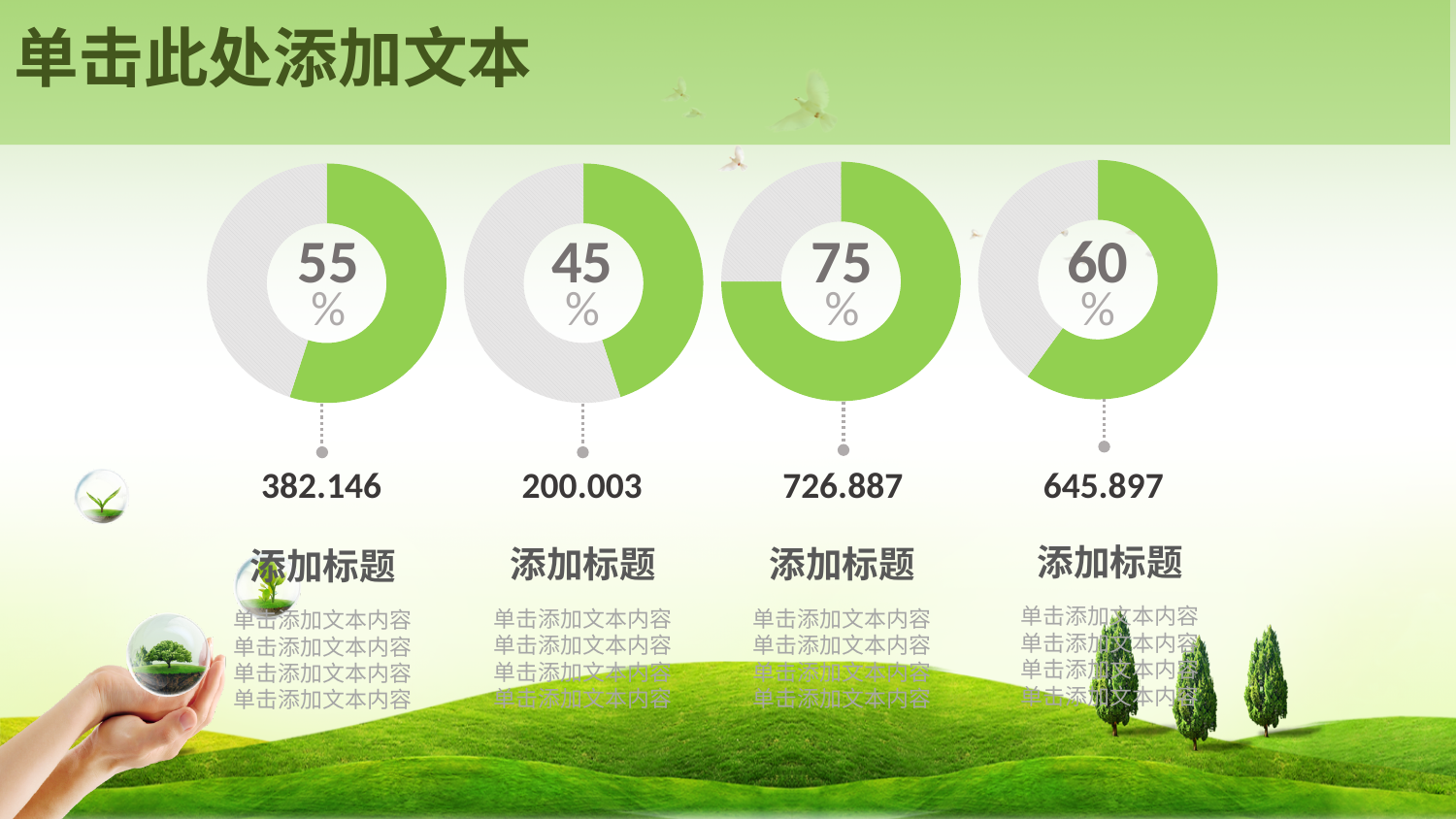
Which is larger: the percentage in the leftmost donut chart or the percentage in the rightmost donut chart? The rightmost (60%) What percentage is shown in the centre of the third donut chart from the left? 75% What is the difference between the percentage in the third donut chart and the percentage in the second donut chart? 30% What percentage is shown in the centre of the rightmost donut chart? 60% What type of chart is used to display the percentages on the slide? Donut (pie) chart What percentage is shown in the centre of the leftmost donut chart? 55% How many donut charts are shown on the slide? 4 What percentage is shown in the centre of the second donut chart from the left? 45% Which of the four donut charts shows the lowest percentage? The second from the left (45%) Which of the four donut charts shows the highest percentage? The third from the left (75%) What number is printed below the third donut chart from the left? 726.887 What number is printed below the leftmost donut chart? 382.146